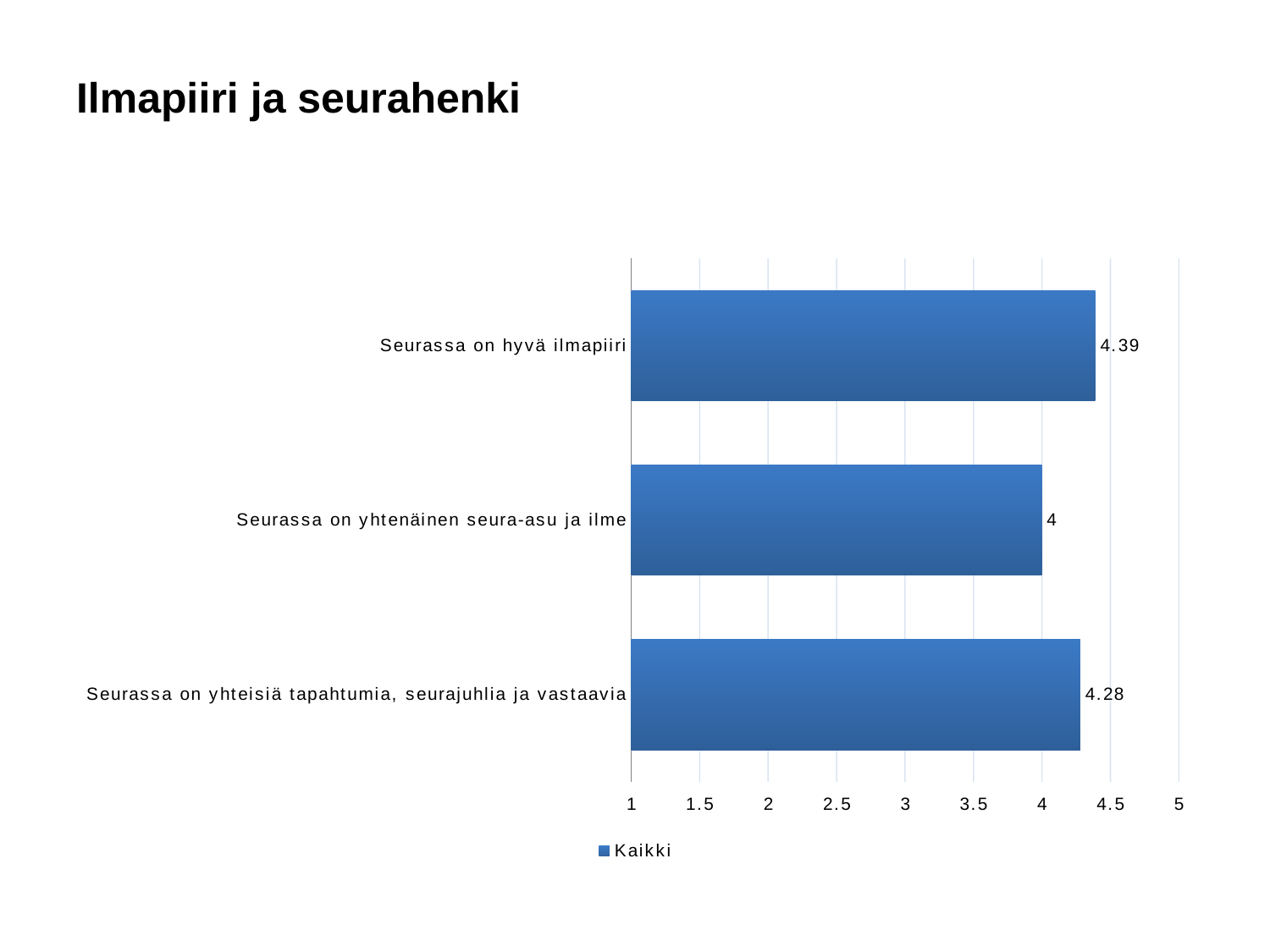
What is the difference between the values for "Seurassa on hyvä ilmapiiri" and "Seurassa on yhteisiä tapahtumia, seurajuhlia ja vastaavia"? 0.11 What is the value for "Seurassa on yhtenäinen seura-asu ja ilme"? 4 What kind of chart is shown on the slide? Bar chart What is the difference between the values for "Seurassa on hyvä ilmapiiri" and "Seurassa on yhtenäinen seura-asu ja ilme"? 0.39 What is the value for "Seurassa on yhteisiä tapahtumia, seurajuhlia ja vastaavia"? 4.28 Is the value for "Seurassa on hyvä ilmapiiri" greater or less than 4? greater How many series does the legend list? 1 What is the value for "Seurassa on hyvä ilmapiiri"? 4.39 Which category has the highest value? Seurassa on hyvä ilmapiiri Which category has the lowest value? Seurassa on yhtenäinen seura-asu ja ilme Which is larger: the value for "Seurassa on yhteisiä tapahtumia, seurajuhlia ja vastaavia" or the value for "Seurassa on yhtenäinen seura-asu ja ilme"? Seurassa on yhteisiä tapahtumia, seurajuhlia ja vastaavia How many categories are shown in the chart? 3